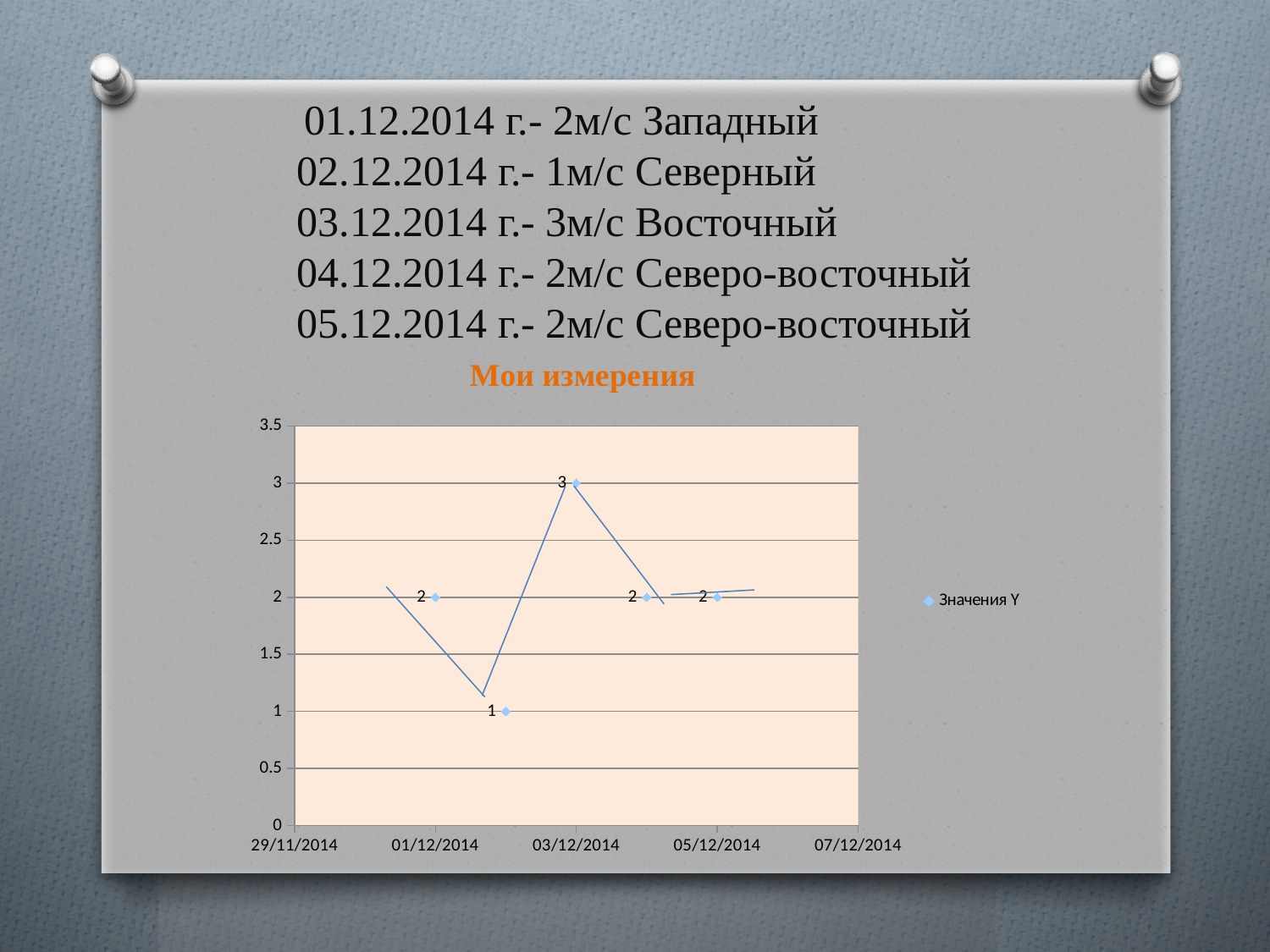
How many series does the legend list? 1 Does the value rise or fall from 03/12/2014 to 04/12/2014? fall What is the value plotted for 01/12/2014? 2 What is the value plotted for 03/12/2014? 3 What is the title of the chart? Мои измерения On which date is the plotted value lowest? 02/12/2014 What is the value plotted for 02/12/2014? 1 What is the difference between the values for 03/12/2014 and 02/12/2014? 2 Which date has the larger value, 01/12/2014 or 02/12/2014? 01/12/2014 How many data points are plotted in the chart? 5 What is the value plotted for 05/12/2014? 2 On which date is the plotted value highest? 03/12/2014